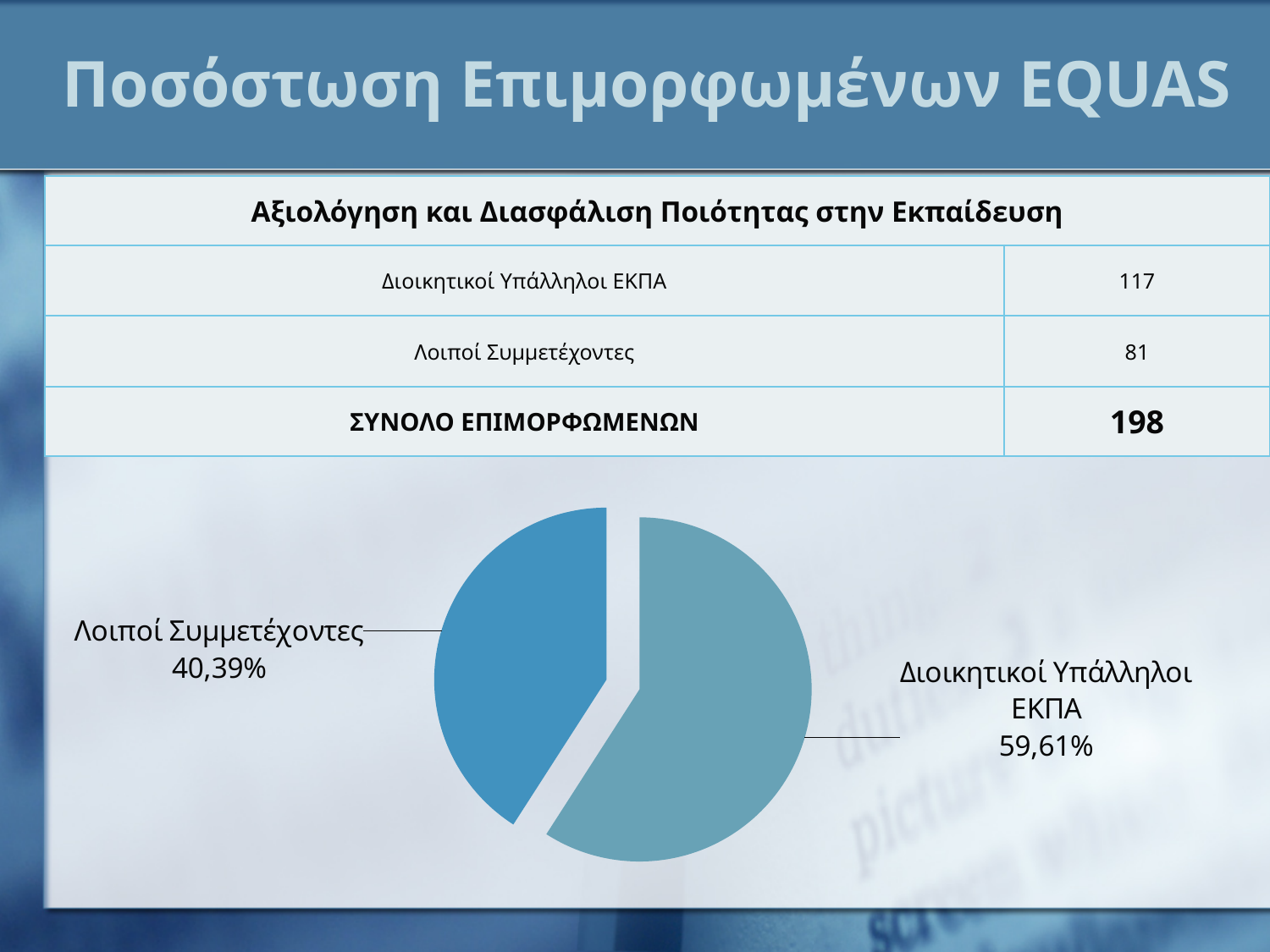
Which slice of the pie chart is the smallest? Λοιποί Συμμετέχοντες What share of the pie chart is labelled for Λοιποί Συμμετέχοντες? 40,39% Is the share for Διοικητικοί Υπάλληλοι ΕΚΠΑ greater or less than 50%? greater Which slice of the pie chart is the largest? Διοικητικοί Υπάλληλοι ΕΚΠΑ What is the difference in percentage points between the Διοικητικοί Υπάλληλοι ΕΚΠΑ slice and the Λοιποί Συμμετέχοντες slice? 19,22% How many slices does the pie chart have? 2 What share of the pie chart is labelled for Διοικητικοί Υπάλληλοι ΕΚΠΑ? 59,61% Which is larger in the pie chart: Διοικητικοί Υπάλληλοι ΕΚΠΑ or Λοιποί Συμμετέχοντες? Διοικητικοί Υπάλληλοι ΕΚΠΑ What kind of chart is shown on the slide? pie chart Is the share for Λοιποί Συμμετέχοντες greater or less than 50%? less What is the title of the slide containing the pie chart? Ποσόστωση Επιμορφωμένων EQUAS